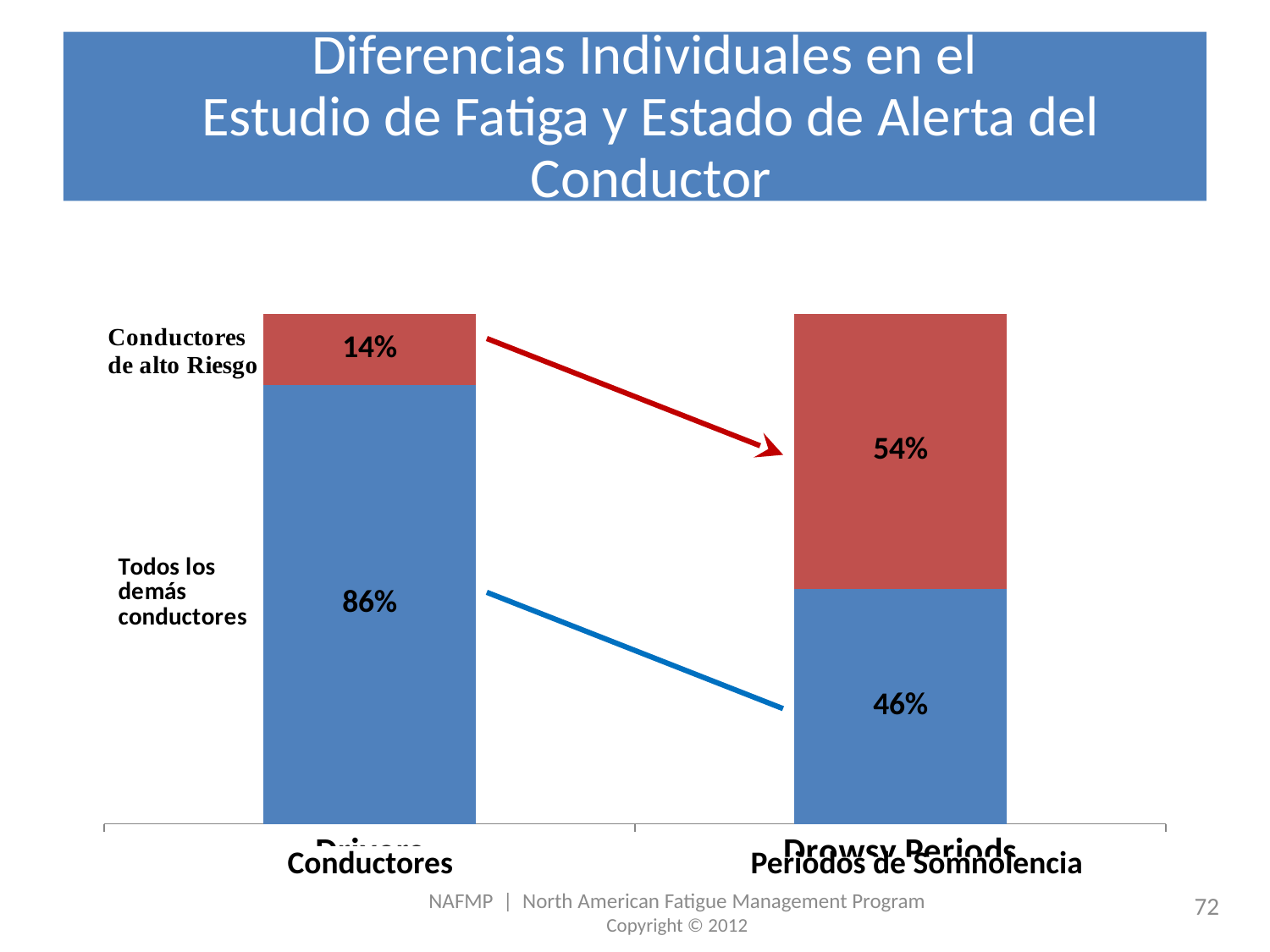
What is the value for Todos los demás conductores in the Periodos de Somnolencia bar? 46% What is the difference between the Conductores de alto Riesgo share in Periodos de Somnolencia and in Conductores? 40% How many categories are shown on the x axis of the chart? 2 What is the value for Todos los demás conductores in the Conductores bar? 86% What is the difference between the Todos los demás conductores share in Conductores and in Periodos de Somnolencia? 40% In the Conductores bar, which segment is larger: Conductores de alto Riesgo or Todos los demás conductores? Todos los demás conductores What is the value for Conductores de alto Riesgo in the Periodos de Somnolencia bar? 54% What type of chart is shown on the slide? stacked bar chart What is the total of the Conductores stacked bar? 100% What is the value for Conductores de alto Riesgo in the Conductores bar? 14% Which colour represents Conductores de alto Riesgo in the chart? red In the Periodos de Somnolencia bar, which segment is larger: Conductores de alto Riesgo or Todos los demás conductores? Conductores de alto Riesgo